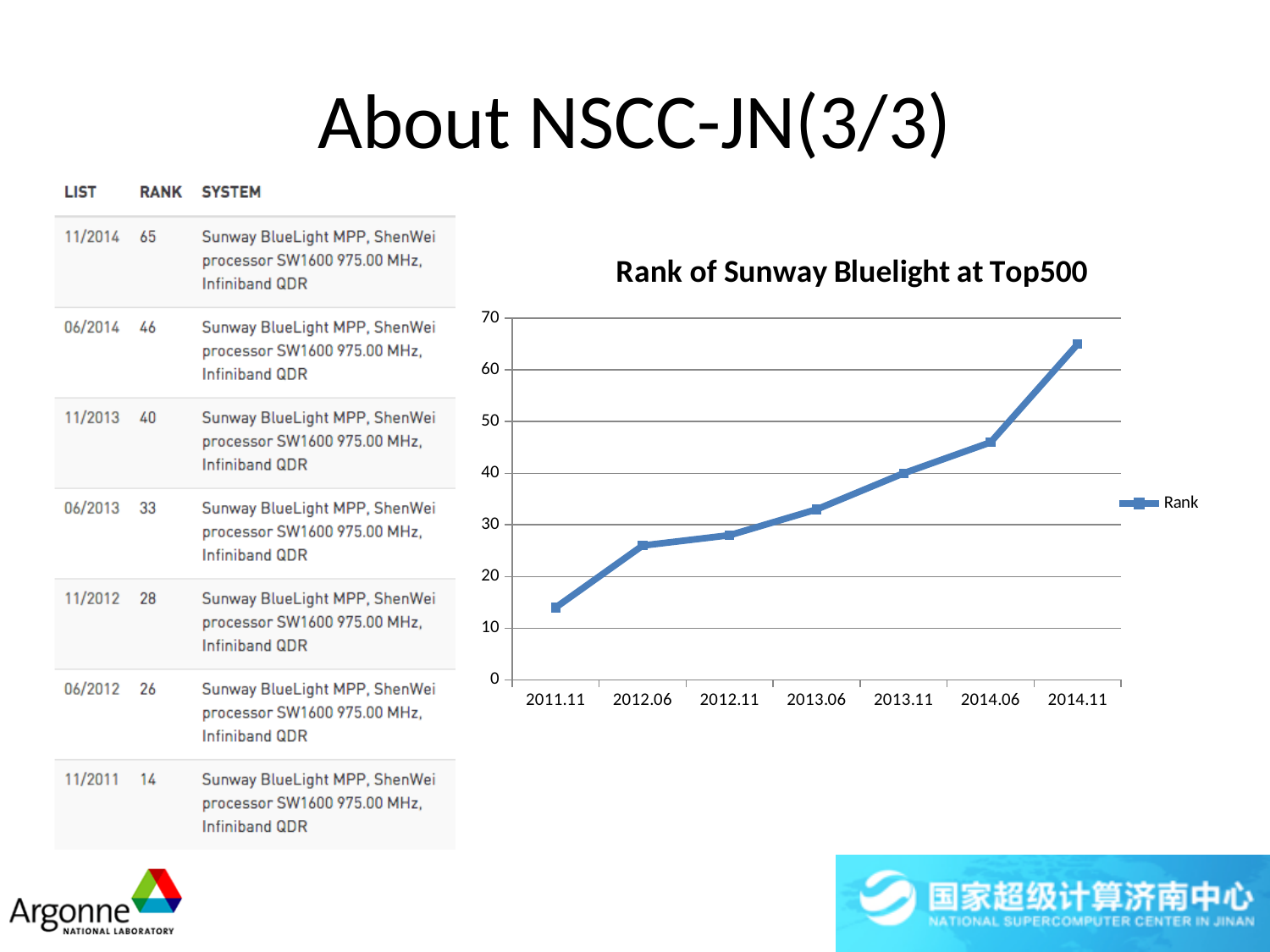
Is the value for 2014.11 greater or less than 60? greater What is the plotted rank value for 2013.11? 40 Is the value for 2011.11 greater or less than 20? less At which date is the plotted rank value highest? 2014.11 What is the name of the series shown in the chart legend? Rank How many data points are plotted on the line? 7 At which date is the plotted rank value lowest? 2011.11 Which has the larger plotted value, 2013.06 or 2014.06? 2014.06 How many series does the chart legend list? 1 What kind of chart is shown on the slide? line chart What is the title of the chart? Rank of Sunway Bluelight at Top500 Do the plotted rank values rise or fall from 2011.11 to 2014.11? rise